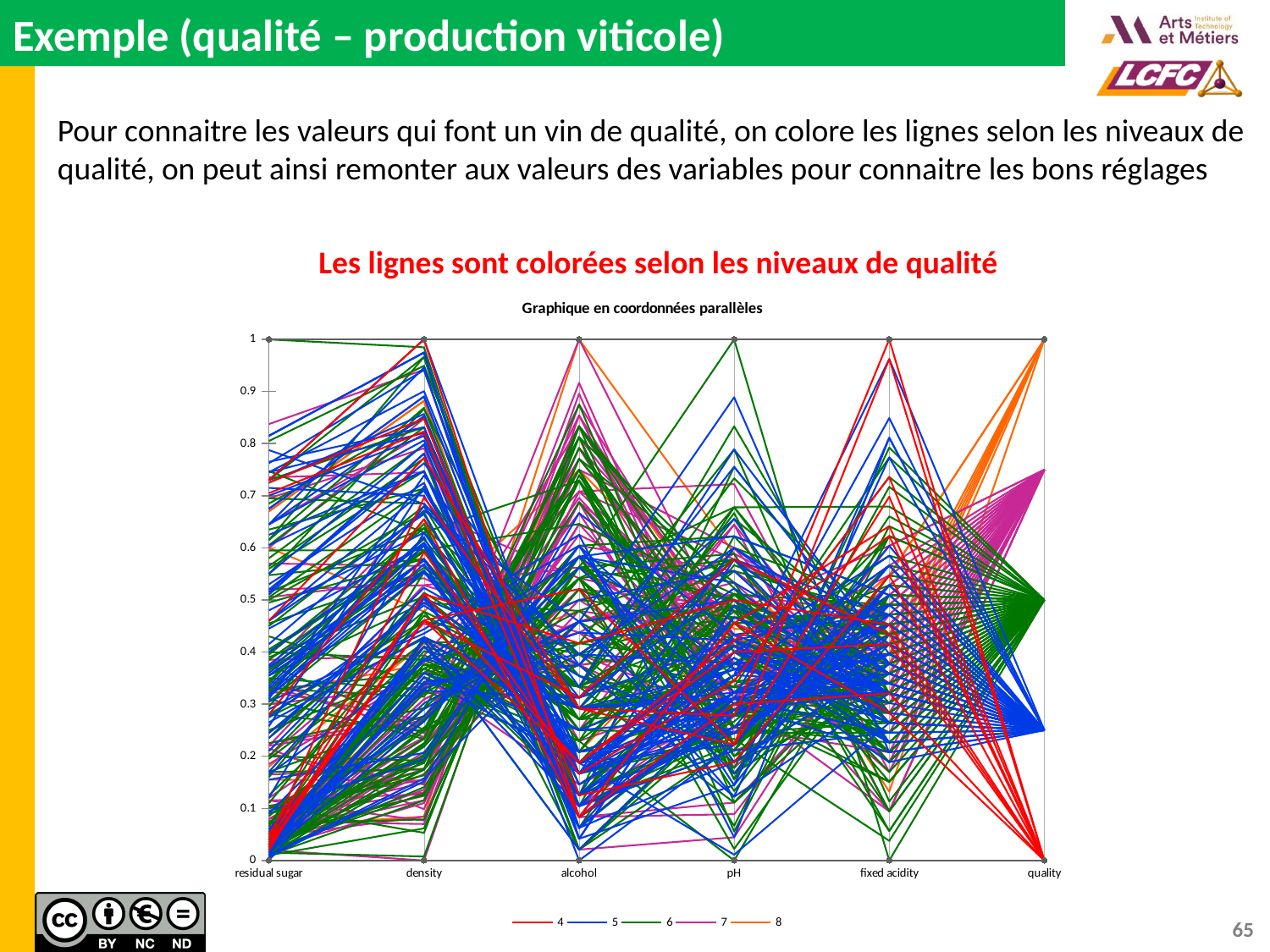
What is the maximum value shown on the vertical axis? 1 On the quality axis, at what value do the lines of series 6 converge? 0.5 Which variable is the last axis on the right of the chart? quality What is the title of the chart? Graphique en coordonnées parallèles On the quality axis, at what value do the lines of series 8 converge? 1 What is the minimum value shown on the vertical axis? 0 On the quality axis, is the value where the series 7 lines converge greater or less than 0.7? greater How many series does the legend list? 5 On the quality axis, at what value do the lines of series 4 converge? 0 On the quality axis, is the value where the series 5 lines converge greater or less than 0.3? less How many variable axes are shown along the x axis of the chart? 6 What kind of chart is shown on the slide? Parallel coordinates chart